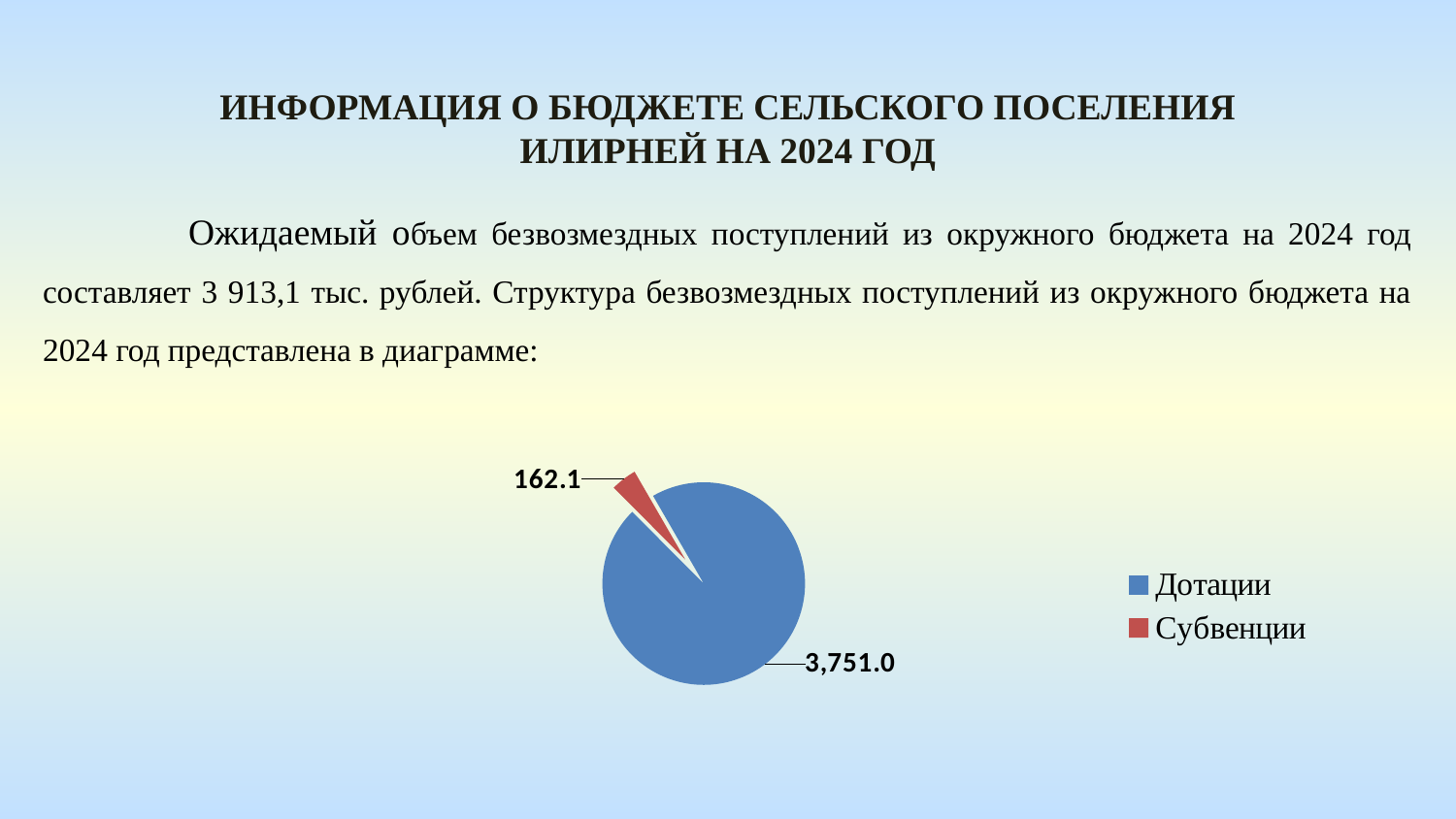
What kind of chart is shown on the slide? Pie chart What is the difference between the Дотации and Субвенции values in the pie chart? 3,588.9 Which category has the largest slice in the pie chart? Дотации Which is larger in the pie chart, Дотации or Субвенции? Дотации How many slices does the pie chart have? 2 What is the total of the two slices in the pie chart? 3,913.1 What share of the pie does the Субвенции slice represent? 4.1% What is the value of the Дотации slice in the pie chart? 3,751.0 What colour is the Субвенции slice in the pie chart? Red Which category has the smallest slice in the pie chart? Субвенции What is the value of the Субвенции slice in the pie chart? 162.1 How many entries does the legend of the pie chart list? 2